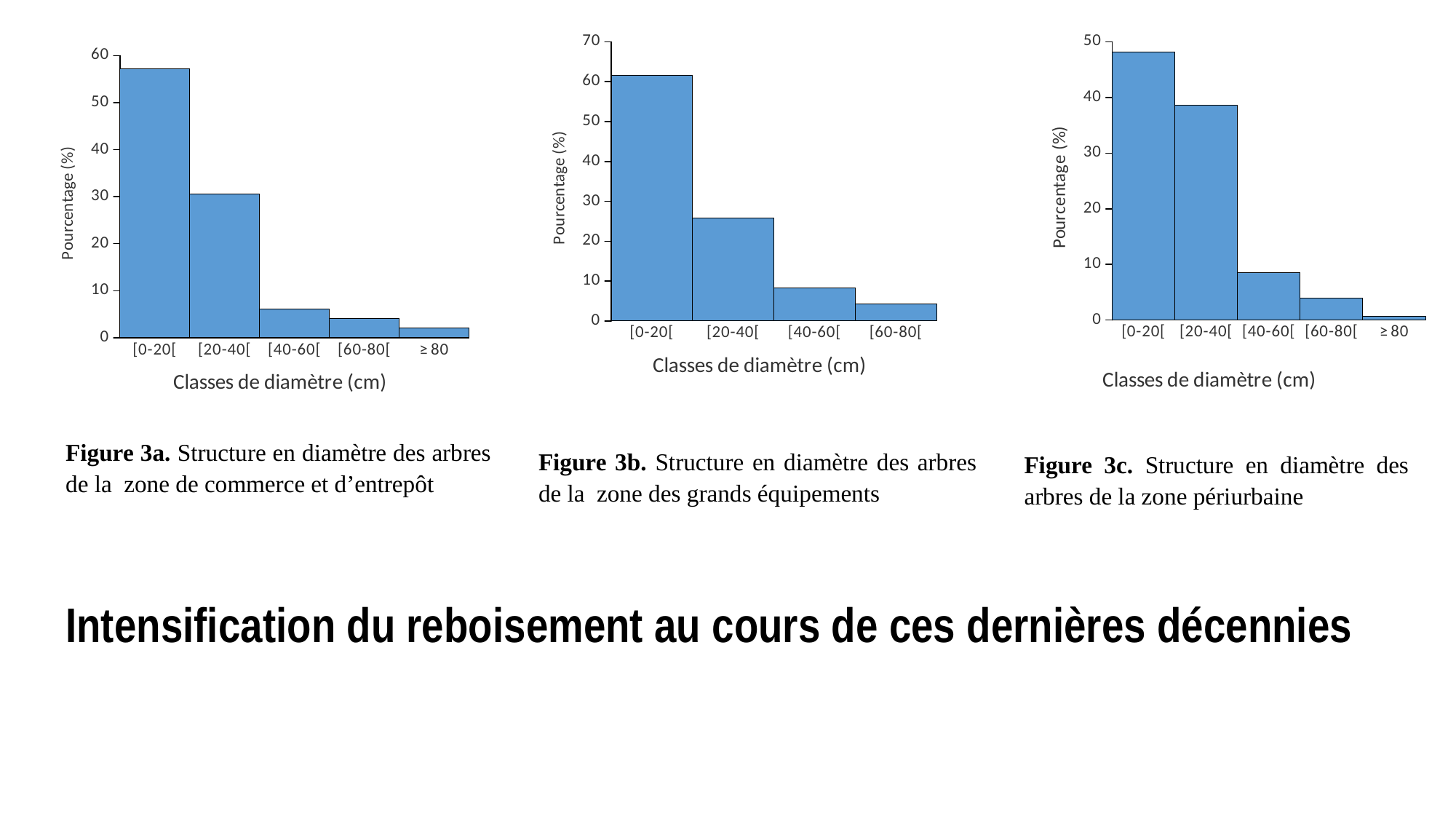
In Figure 3c (right chart), is the value for [0-20[ greater or less than 40? greater In Figure 3a (left chart), is the value for [20-40[ greater or less than 40? less In Figure 3a (left chart), which diameter class has the highest percentage? [0-20[ In Figure 3b (middle chart), which diameter class has the lowest percentage? [60-80[ In Figure 3b (middle chart), do the percentages rise or fall from [0-20[ to [60-80[? fall In Figure 3c (right chart), which is larger, the value for [20-40[ or the value for [40-60[? [20-40[ In Figure 3c (right chart), which diameter class has the lowest percentage? ≥ 80 In Figure 3a (left chart), is the value for [0-20[ greater or less than 50? greater What kind of chart is Figure 3c (right chart)? bar chart How many diameter classes are shown in Figure 3b (middle chart)? 4 How many diameter classes are shown in Figure 3a (left chart)? 5